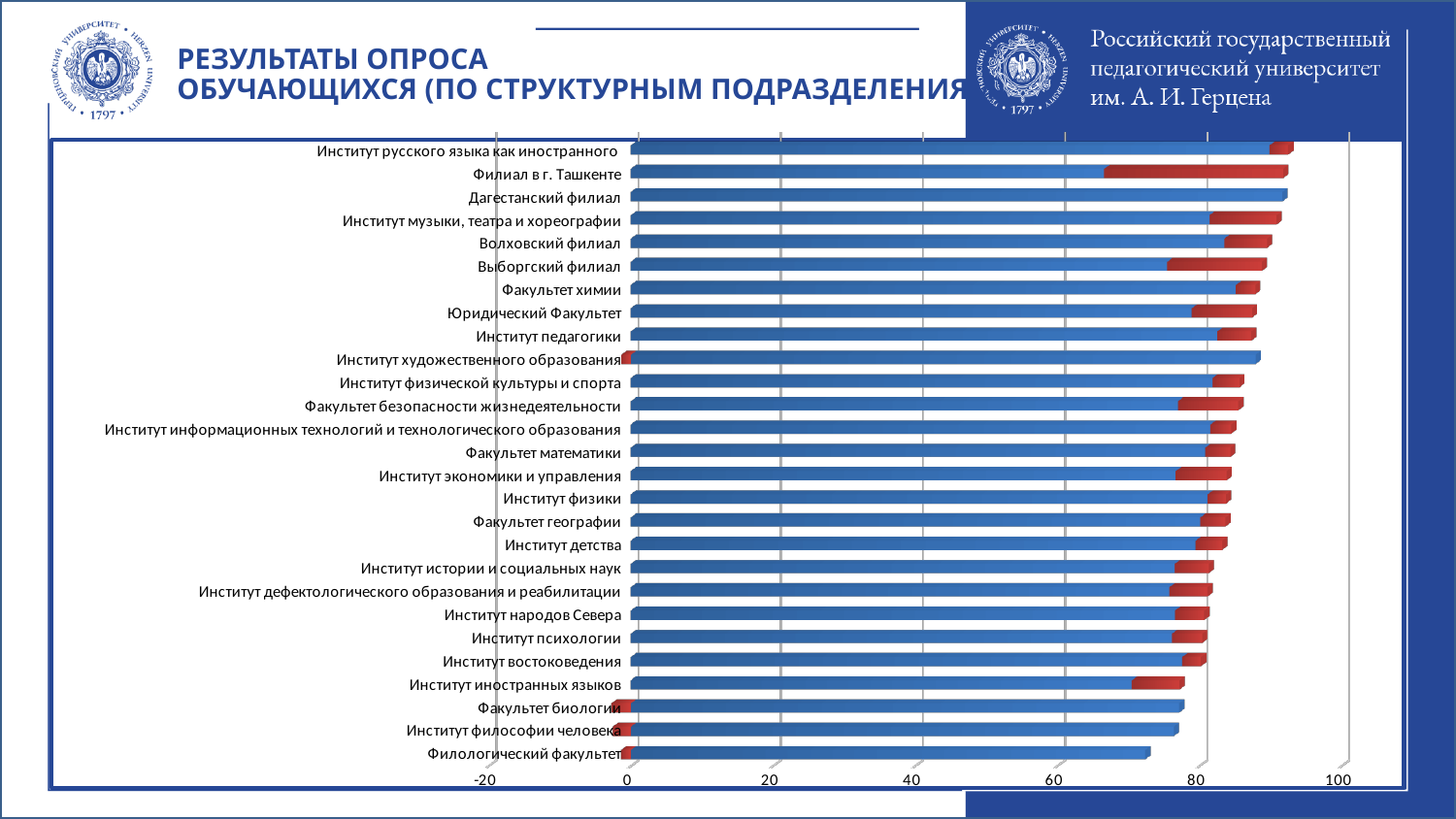
Which category has the longest bar on the chart? Институт русского языка как иностранного Which has the longer blue segment: Филиал в г. Ташкенте or Дагестанский филиал? Дагестанский филиал How many structural units (categories) are listed on the chart? 27 Is the blue segment for Институт иностранных языков greater or less than 80? less Is the total bar length for Филологический факультет greater or less than 80? less Do the total bar lengths increase or decrease going from the top category to the bottom category? decrease What kind of chart is shown on the slide? bar chart What is the lowest value shown on the horizontal axis? -20 Which has the longer total bar: Дагестанский филиал or Филологический факультет? Дагестанский филиал Is the blue segment for Филиал в г. Ташкенте greater or less than 80? less Which category has the shortest bar on the chart? Филологический факультет